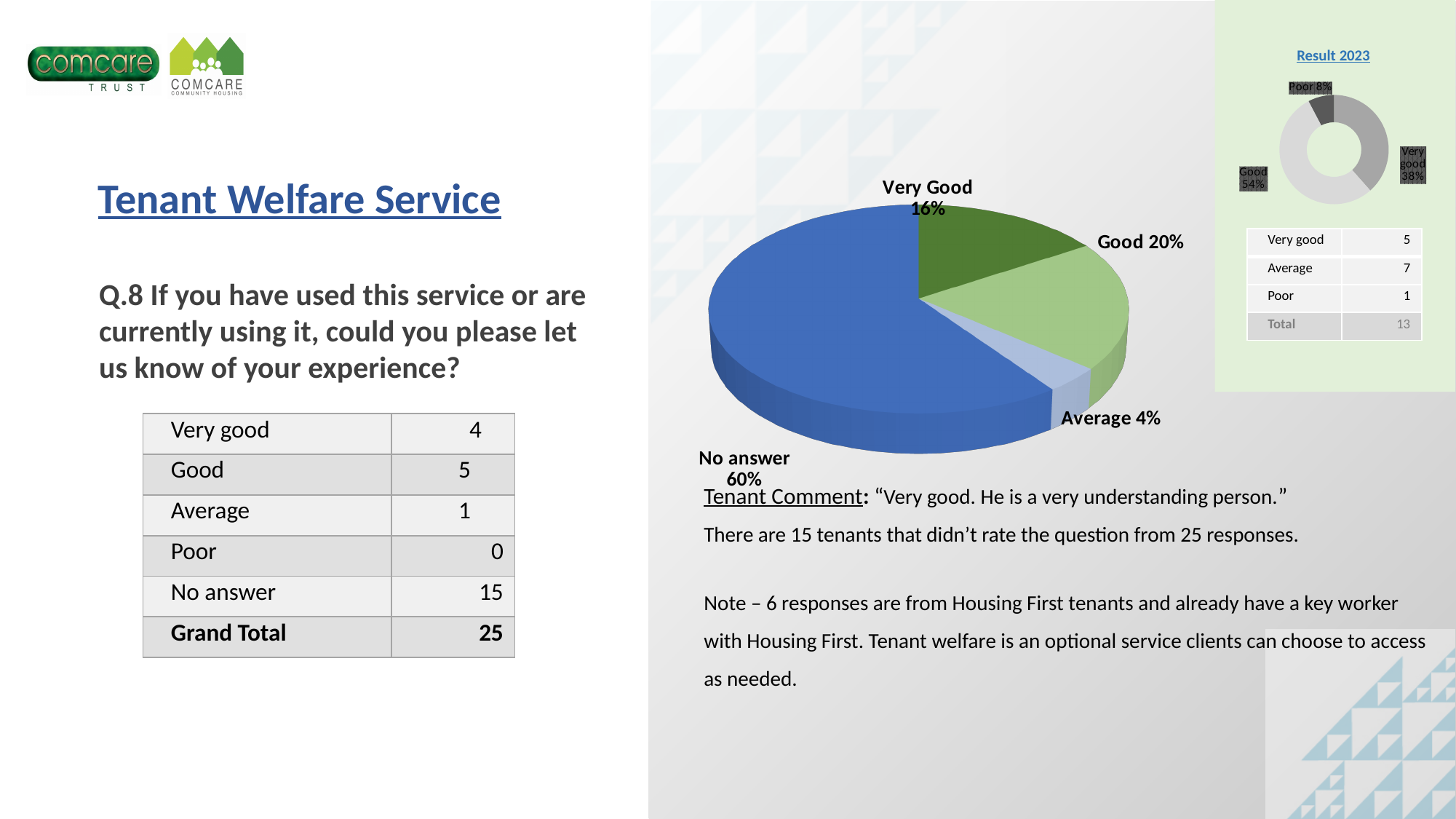
On the small "Result 2023" chart, what percentage is shown for "Good"? 54% On the large pie chart, what percentage is shown for "Average"? 4% On the large pie chart, how many slices are labelled? 4 On the large pie chart, what share of responses is labelled "No answer"? 60% On the large pie chart, which is larger, "Good" or "Average"? Good On the large pie chart, what percentage is shown for "Good"? 20% On the large pie chart, what is the difference in percentage points between "Good" and "Very Good"? 4% On the large pie chart, what percentage is shown for "Very Good"? 16% What kind of chart is the large chart in the middle of the slide? Pie chart On the small "Result 2023" chart, which category has the smallest share? Poor On the large pie chart, which category has the largest slice? No answer On the large pie chart, which category has the smallest slice? Average